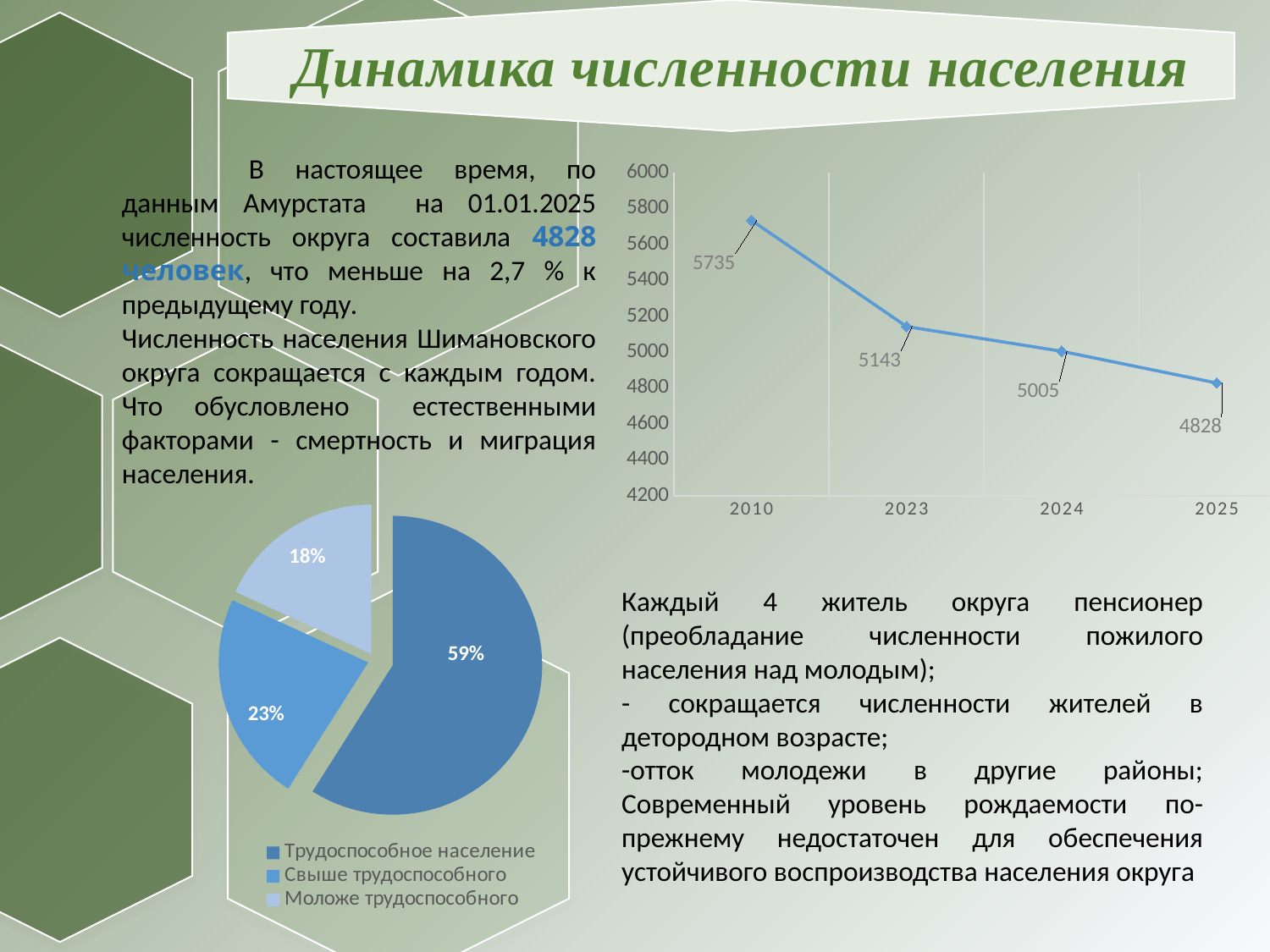
On the line chart at the top right, what is the value for 2023? 5143 On the line chart at the top right, which year has the lowest value? 2025 On the pie chart at the bottom left, which category has the smallest share? Моложе трудоспособного On the line chart at the top right, what is the population value for 2025? 4828 On the line chart at the top right, how many data points are plotted? 4 What kind of chart is shown at the top right of the slide? line chart On the line chart at the top right, which year has the highest value? 2010 On the line chart at the top right, what is the difference between the values for 2024 and 2025? 177 On the line chart at the top right, what is the population value for 2010? 5735 On the line chart at the top right, do the values rise or fall from 2010 to 2025? fall How many categories does the legend of the pie chart at the bottom left list? 3 On the pie chart at the bottom left, what share is labelled for Трудоспособное население? 59%